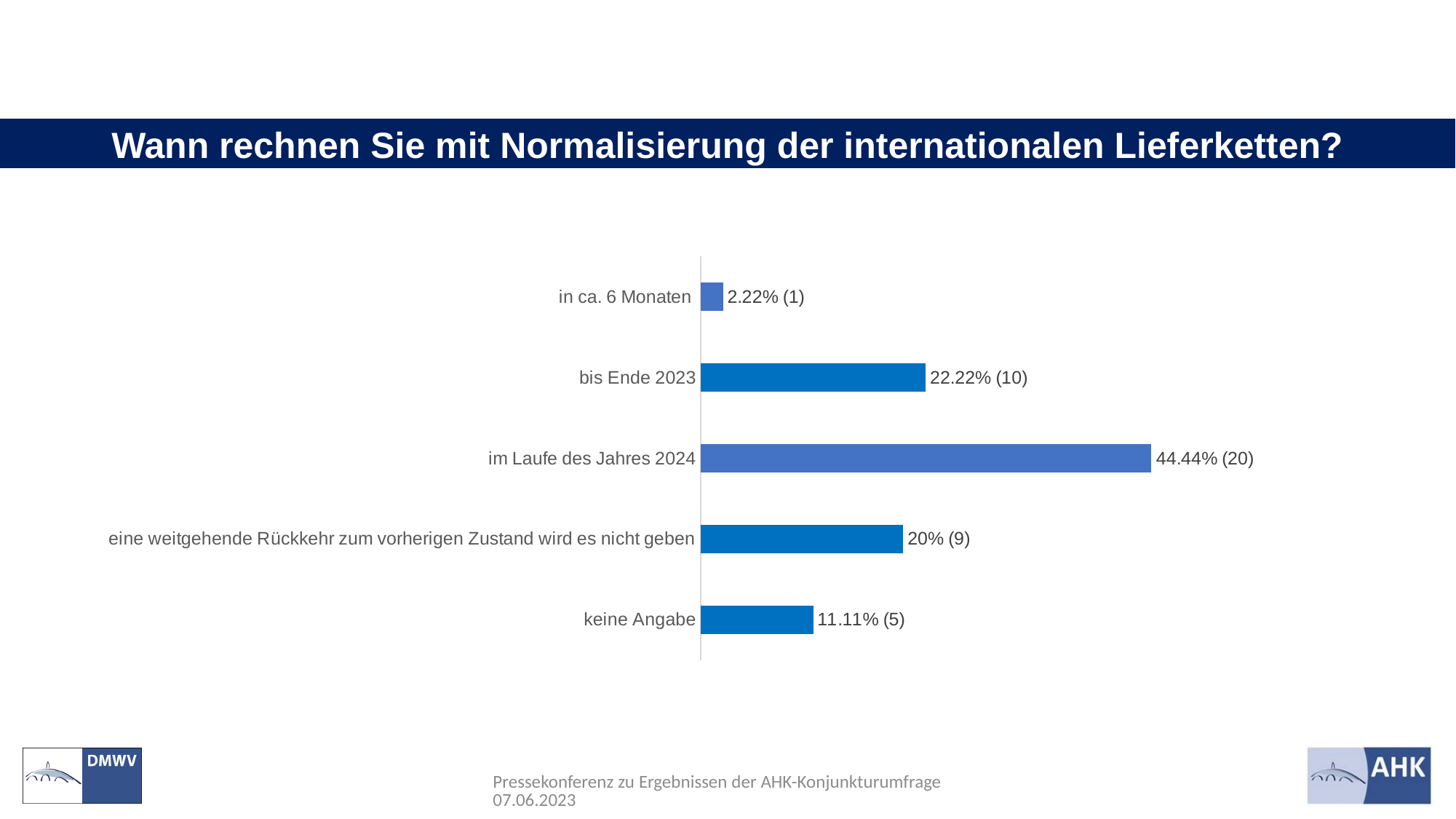
What is the title of the chart on the slide? Wann rechnen Sie mit Normalisierung der internationalen Lieferketten? What is the difference in percentage points between "im Laufe des Jahres 2024" and "bis Ende 2023"? 22.22 What kind of chart is shown on the slide? bar chart What is the data label for "in ca. 6 Monaten"? 2.22% (1) How many respondents in total are represented by the counts in parentheses? 45 How many respondents are shown in parentheses for "keine Angabe"? 5 Which is larger: the value for "bis Ende 2023" or the value for "eine weitgehende Rückkehr zum vorherigen Zustand wird es nicht geben"? bis Ende 2023 What percentage is shown for "im Laufe des Jahres 2024"? 44.44% Which category has the highest value? im Laufe des Jahres 2024 How many categories does the chart show? 5 What percentage is shown for "bis Ende 2023"? 22.22% Which category has the lowest value? in ca. 6 Monaten